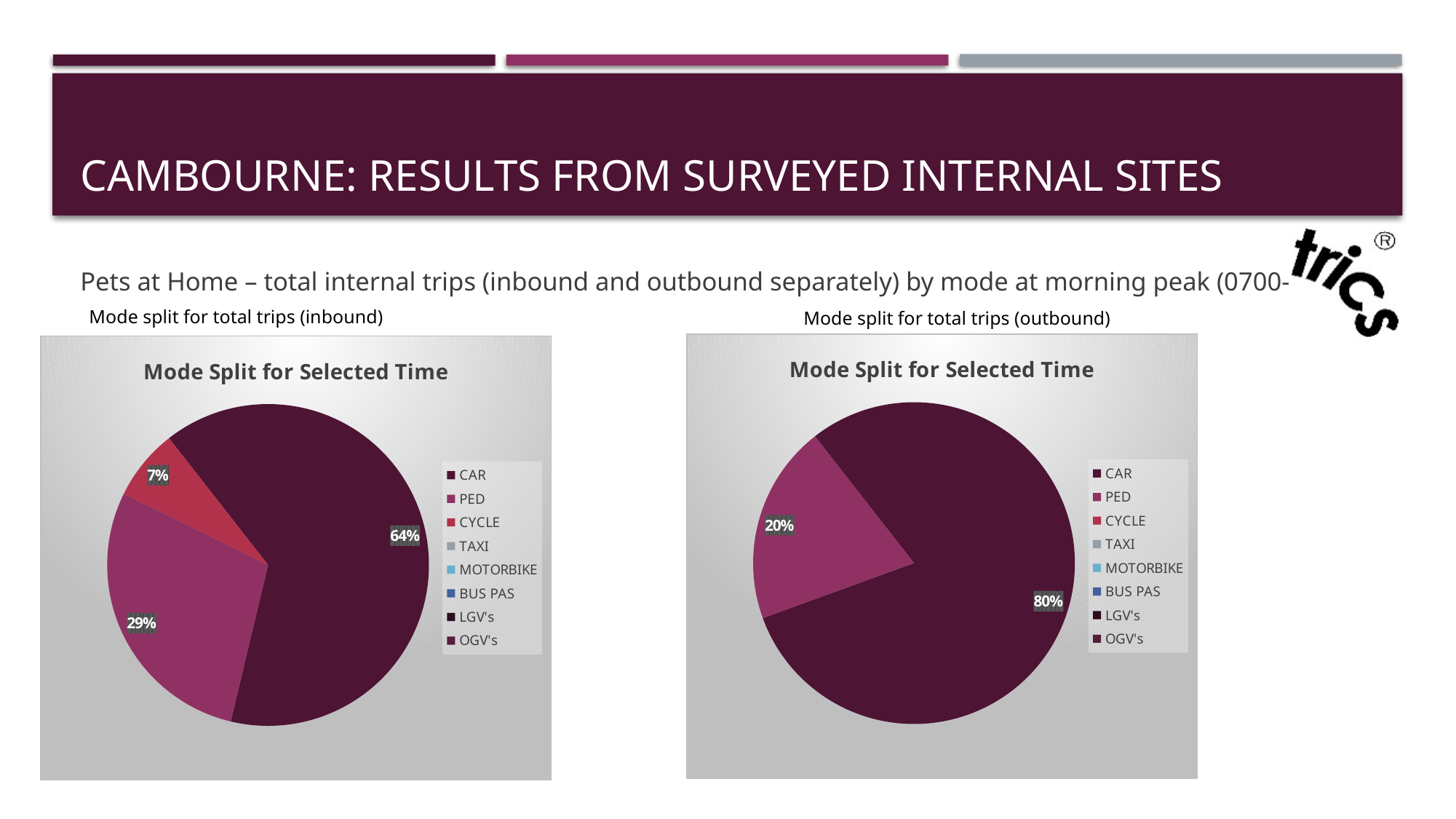
In the outbound mode split pie chart on the right, what share of trips is CAR? 80% Is the CAR share larger in the inbound pie chart or the outbound pie chart? Outbound In the inbound mode split pie chart on the left, which mode has the largest share? CAR How many entries does the legend of the outbound mode split pie chart list? 8 What type of chart is used to show the mode split for total trips (inbound)? Pie chart In the inbound mode split pie chart on the left, what share of trips is PED? 29% In the inbound mode split pie chart on the left, which of the labelled modes has the smallest share? CYCLE In the inbound mode split pie chart on the left, what is the difference between the CAR share and the PED share? 35% In the inbound mode split pie chart on the left, what share of trips is CAR? 64% What is the title shown inside each of the two charts on the slide? Mode Split for Selected Time